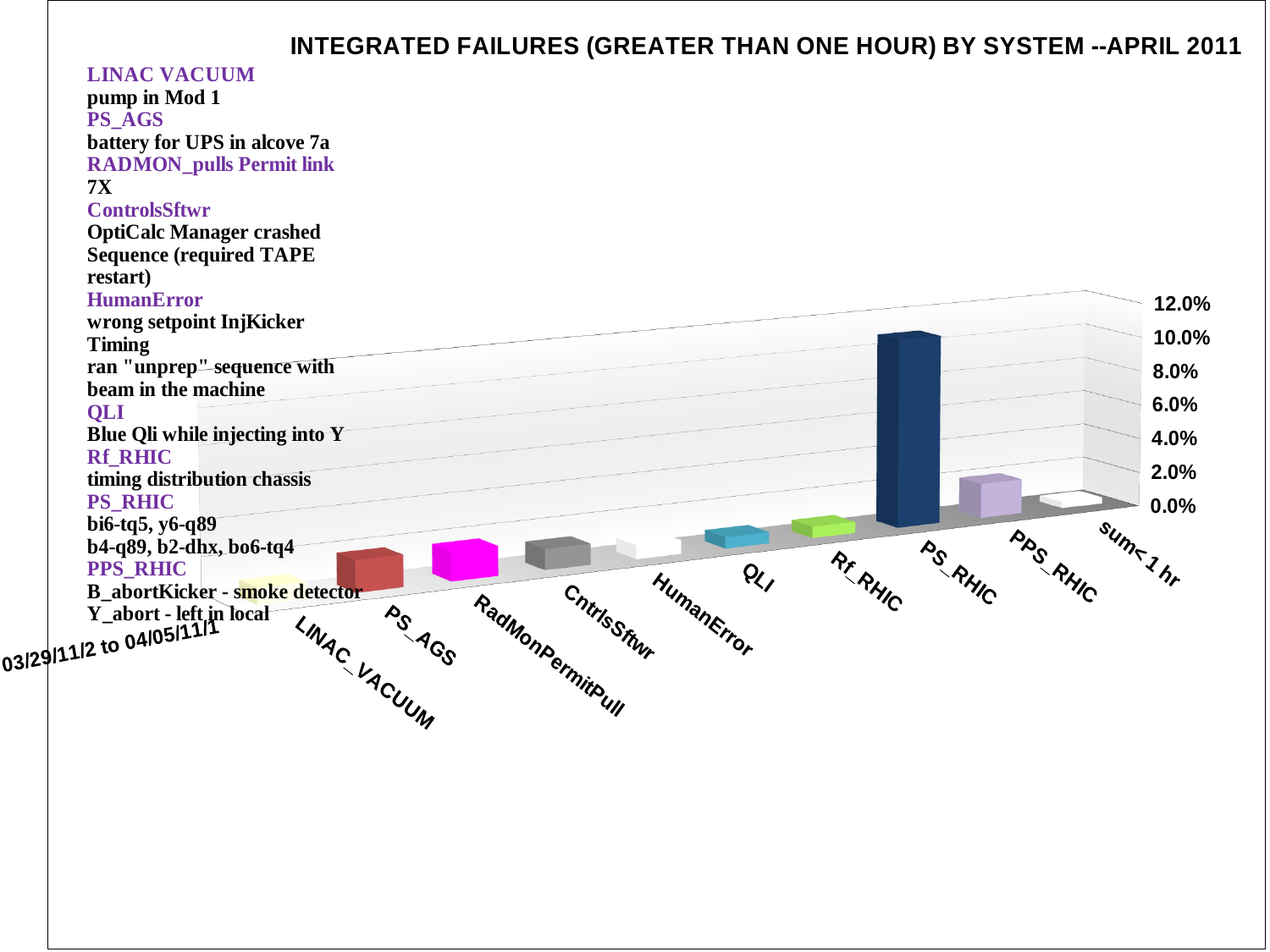
Which is larger, the value for PS_RHIC or the value for PPS_RHIC? PS_RHIC Which is larger, the value for PS_RHIC or the value for LINAC_VACUUM? PS_RHIC Which category has the highest value in the chart? PS_RHIC How many categories are shown along the x axis of the chart? 10 What is the highest value shown on the vertical axis of the chart? 12.0% Is the value for QLI greater or less than 6.0%? less Is the value for PS_RHIC greater or less than 8.0%? greater What is the title of the chart? INTEGRATED FAILURES (GREATER THAN ONE HOUR) BY SYSTEM --APRIL 2011 What kind of chart is shown on the slide? bar chart Is the value for LINAC_VACUUM greater or less than 6.0%? less